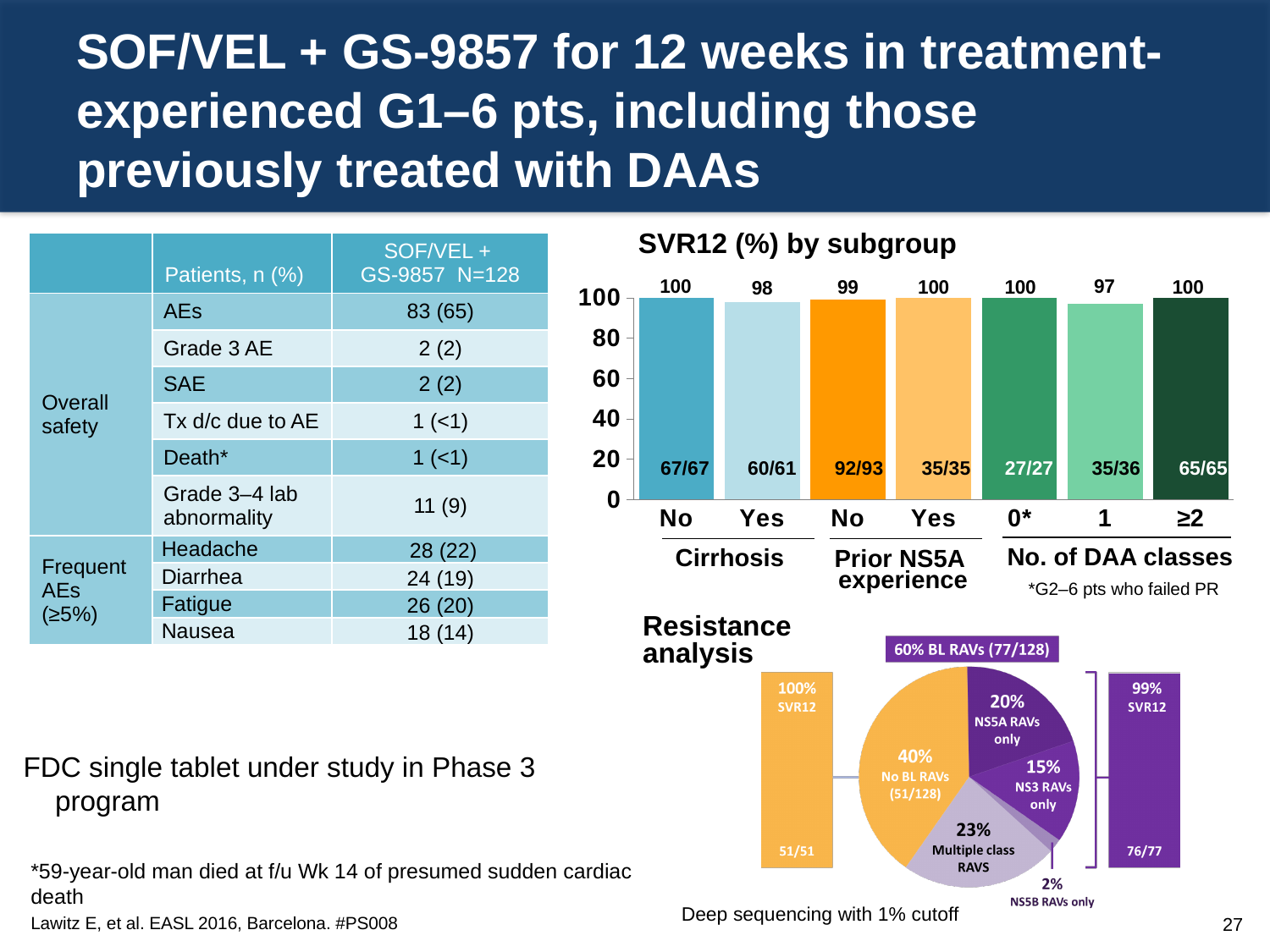
In the 'SVR12 (%) by subgroup' bar chart, what is the difference in SVR12 between patients with no cirrhosis and patients with cirrhosis? 2 In the resistance analysis pie chart, what share of patients had NS5A RAVs only? 20% In the resistance analysis pie chart, what share of patients had multiple class RAVs? 23% In the 'SVR12 (%) by subgroup' bar chart, what is the SVR12 value for patients with cirrhosis (Yes)? 98 How many bars are shown in the 'SVR12 (%) by subgroup' bar chart? 7 In the 'SVR12 (%) by subgroup' bar chart, what fraction is printed on the bar for patients with prior NS5A experience (Yes)? 35/35 In the resistance analysis pie chart, which slice is the smallest? NS5B RAVs only (2%) In the 'SVR12 (%) by subgroup' bar chart, which is larger: the SVR12 for 1 DAA class or for ≥2 DAA classes? ≥2 DAA classes In the 'SVR12 (%) by subgroup' bar chart, which subgroup has the lowest SVR12 value? 1 (No. of DAA classes) In the 'SVR12 (%) by subgroup' bar chart, what is the SVR12 value for patients with no prior NS5A experience? 99 What type of chart is the 'SVR12 (%) by subgroup' chart? Bar chart In the 'SVR12 (%) by subgroup' bar chart, what is the SVR12 value for patients with 1 DAA class? 97